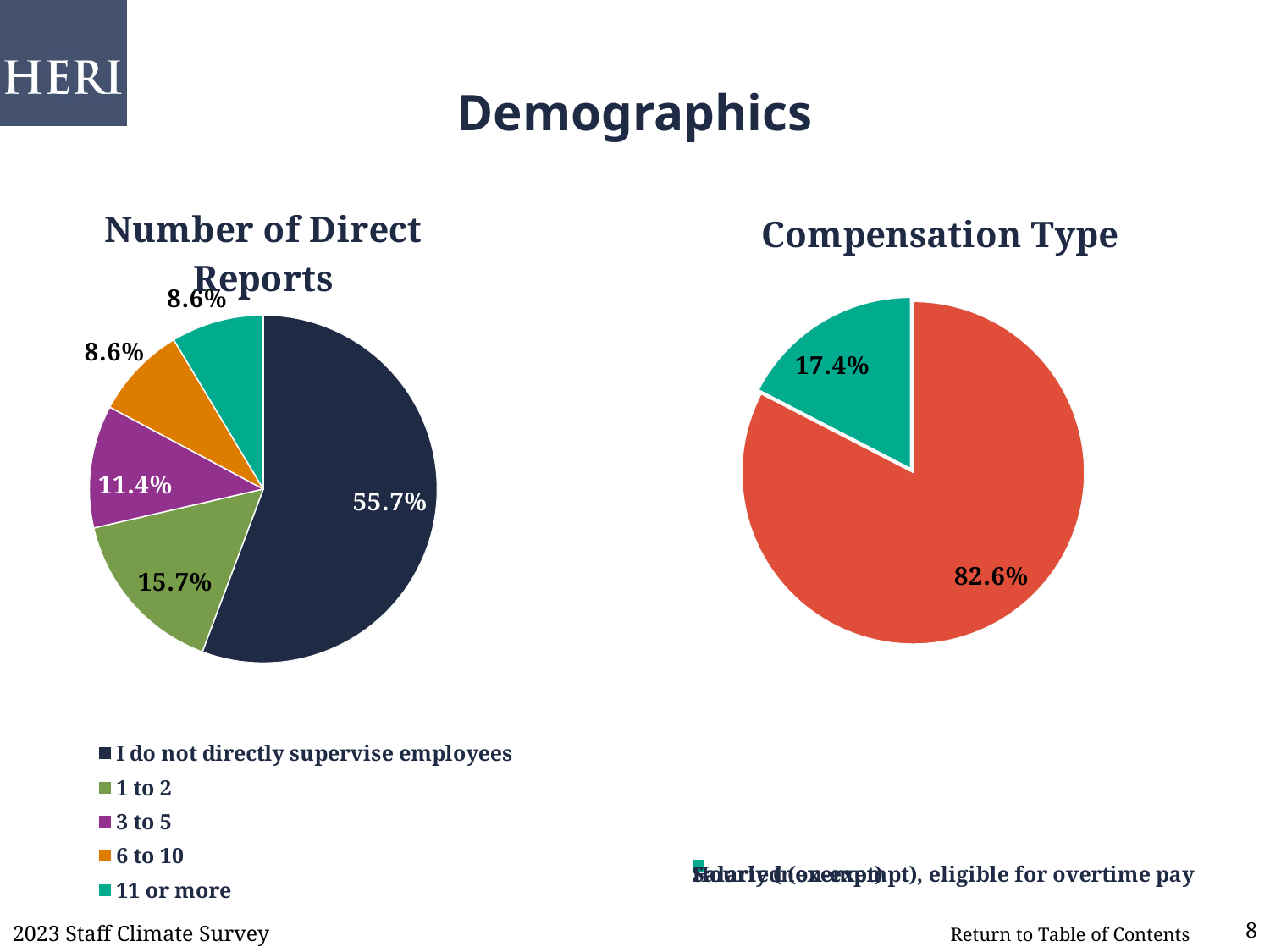
In the Compensation Type chart, what is the value of the largest slice? 82.6% In the Number of Direct Reports chart, what is the difference between the share with 1 to 2 direct reports and the share with 3 to 5 direct reports? 4.3% In the Compensation Type chart, what is the value of the smallest slice? 17.4% How many categories does the legend of the Number of Direct Reports chart list? 5 How many slices does the Compensation Type pie chart have? 2 In the Number of Direct Reports chart, what share of respondents said they do not directly supervise employees? 55.7% In the Number of Direct Reports chart, which category has the largest slice? I do not directly supervise employees In the Compensation Type chart, what is the difference between the two slices? 65.2% In the Number of Direct Reports chart, what percentage of respondents have 1 to 2 direct reports? 15.7% In the Number of Direct Reports chart, which is larger: the share with 1 to 2 direct reports or the share with 6 to 10 direct reports? 1 to 2 In the Number of Direct Reports chart, what percentage of respondents have 3 to 5 direct reports? 11.4% What type of chart is the Number of Direct Reports chart? Pie chart